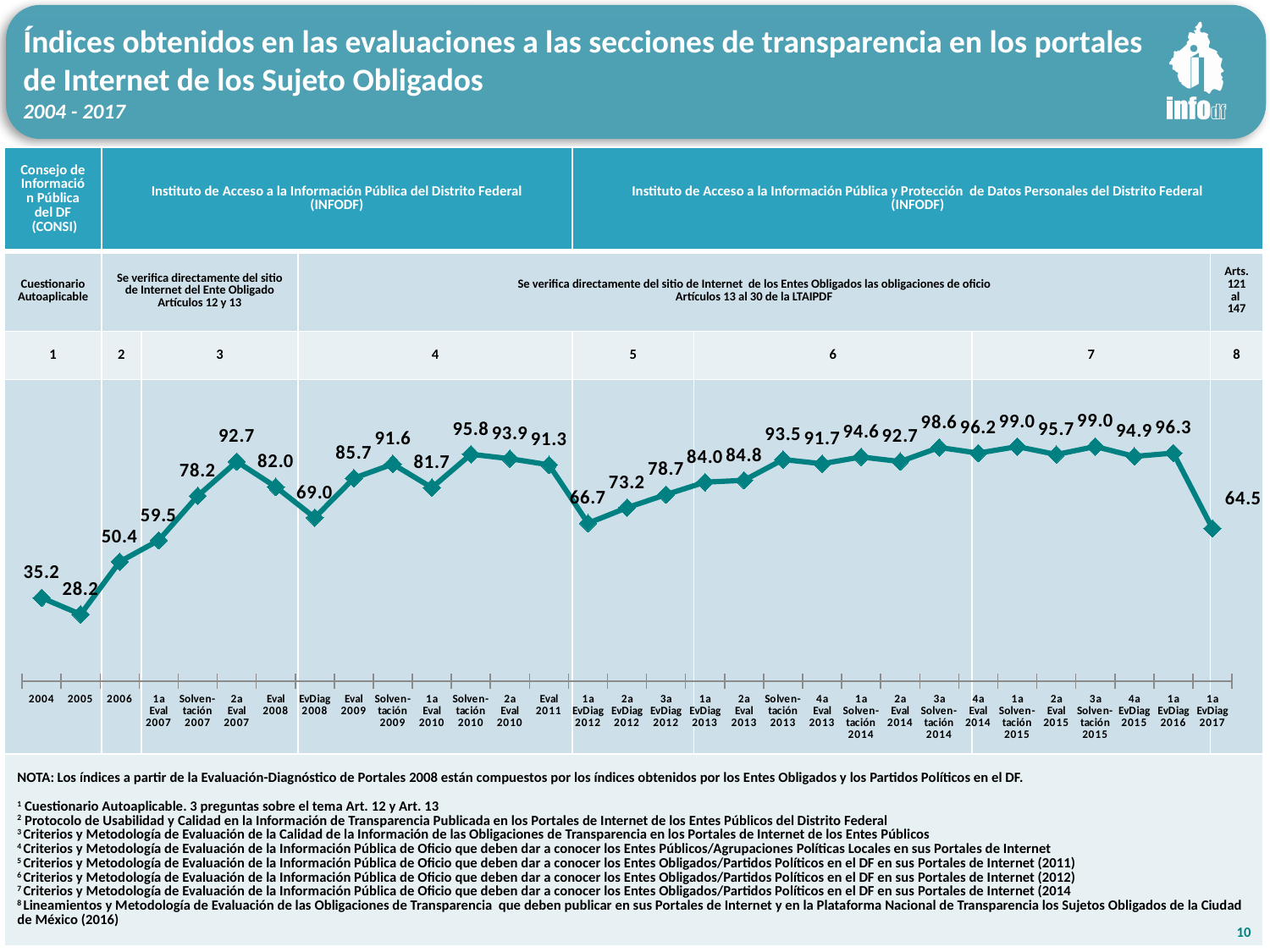
What is the difference between the index values for 1a EvDiag 2016 and 1a EvDiag 2017? 31.8 What index value is shown for 2004? 35.2 Which evaluation has the lowest index value on the chart? 2005 What index value is shown for 1a EvDiag 2017? 64.5 What index value is shown for 1a EvDiag 2012? 66.7 Which has a higher index value, 2005 or 2006? 2006 What index value is shown for 3a Solventación 2014? 98.6 Does the index value rise or fall from 1a EvDiag 2016 to 1a EvDiag 2017? Fall What is the difference between the index values for 2004 and 2005? 7.0 What kind of chart is shown on the slide? Line chart Which has a higher index value, 2a Eval 2007 or Eval 2008? 2a Eval 2007 What index value is shown for Eval 2011? 91.3